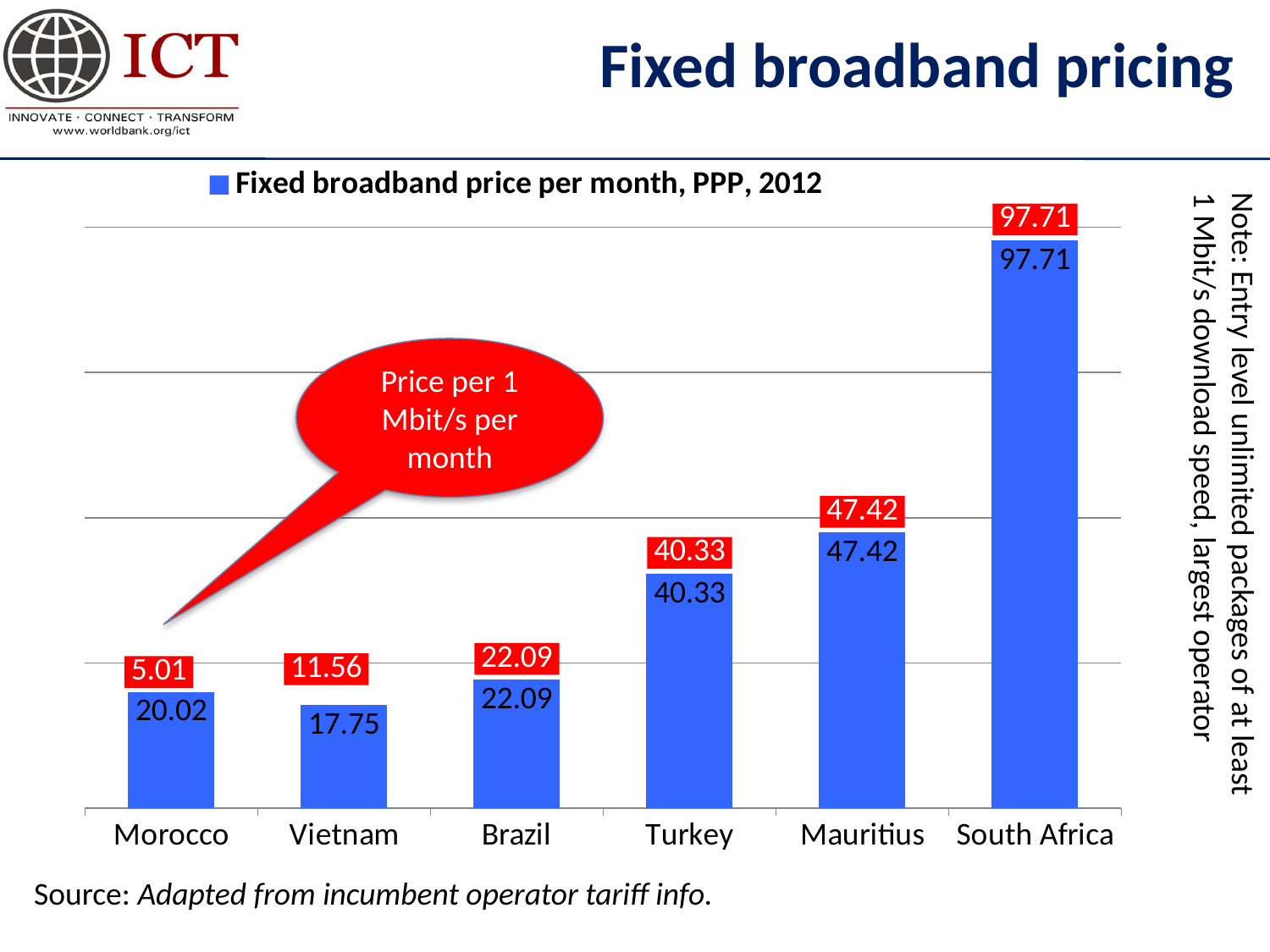
Which has a higher fixed broadband price per month, Brazil or Turkey? Turkey What is the legend entry for the series shown on the chart? Fixed broadband price per month, PPP, 2012 Which country has the highest fixed broadband price per month? South Africa Which country has the lowest fixed broadband price per month? Vietnam What is the fixed broadband price per month for Vietnam, as labelled on the bar? 17.75 What is the difference between the fixed broadband price per month for South Africa and Mauritius? 50.29 According to the red label above the Morocco bar, what is the price per 1 Mbit/s per month for Morocco? 5.01 What is the fixed broadband price per month for Morocco, as labelled on the bar? 20.02 How many series does the legend list? 1 How many countries are shown on the chart? 6 What kind of chart is shown on the slide? Bar chart What is the fixed broadband price per month for Turkey, as labelled on the bar? 40.33